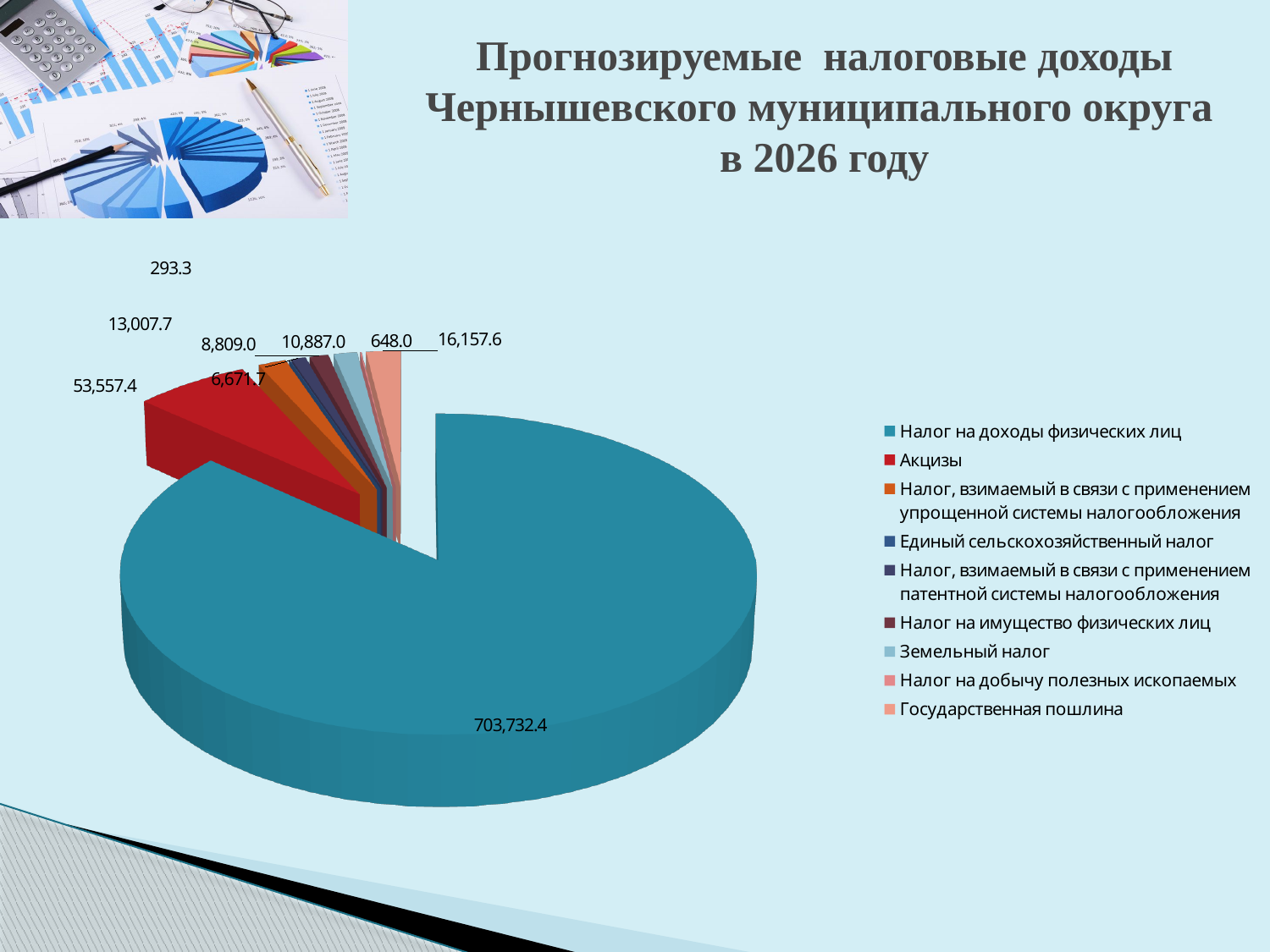
What colour is used for Акцизы in the pie chart? red What kind of chart is shown on the slide? pie chart Which is larger: the value for Акцизы or the value for Налог, взимаемый в связи с применением упрощенной системы налогообложения? Акцизы What is the value shown for Налог, взимаемый в связи с применением упрощенной системы налогообложения? 13,007.7 What is the value shown for Акцизы? 53,557.4 Which category has the largest slice of the pie chart? Налог на доходы физических лиц What is the difference between the value for Налог на доходы физических лиц and the value for Акцизы? 650,175.0 How many categories does the legend of the pie chart list? 9 What is the value shown for Налог на доходы физических лиц? 703,732.4 What is the title of the chart on the slide? Прогнозируемые налоговые доходы Чернышевского муниципального округа в 2026 году What is the smallest data label value printed on the pie chart? 293.3 What is the difference between the value for Акцизы and the value for Налог, взимаемый в связи с применением упрощенной системы налогообложения? 40,549.7